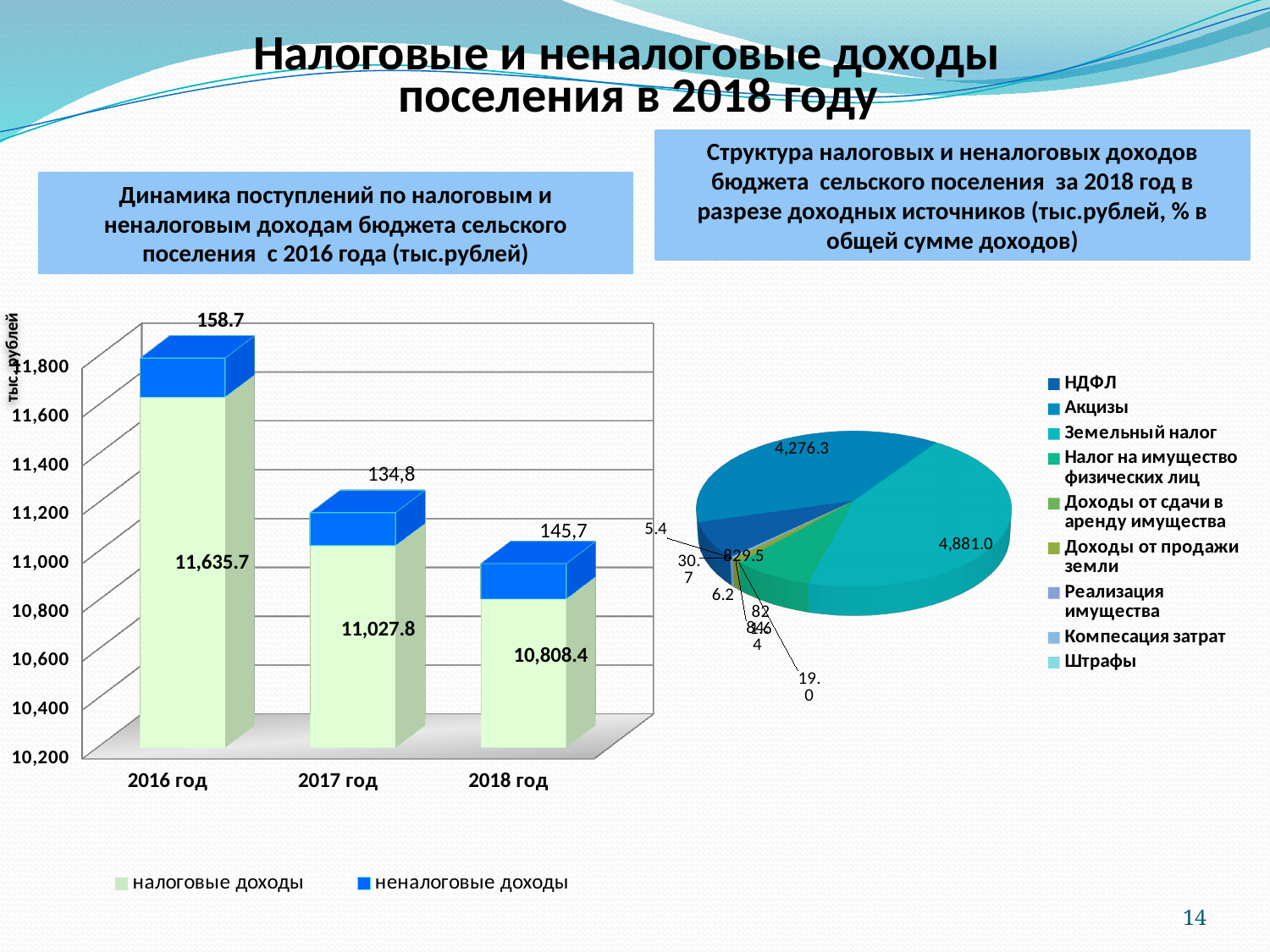
In the left bar chart, what is the value of неналоговые доходы for 2017 год? 134,8 In the right pie chart, which category has the largest slice? Земельный налог What kind of chart is the right chart, 'Структура налоговых и неналоговых доходов'? pie chart In the left bar chart, what is the value of налоговые доходы for 2018 год? 10,808.4 In the left bar chart, which year has the lowest неналоговые доходы? 2017 год In the left bar chart, which year has the highest налоговые доходы? 2016 год How many categories does the legend of the right pie chart list? 9 In the left bar chart, do налоговые доходы rise or fall from 2016 год to 2018 год? fall In the left bar chart, what is the value of налоговые доходы for 2016 год? 11,635.7 What kind of chart is the left chart, 'Динамика поступлений по налоговым и неналоговым доходам'? bar chart How many series does the legend of the left bar chart list? 2 In the left bar chart, what is the difference between налоговые доходы in 2016 год and 2017 год? 607.9